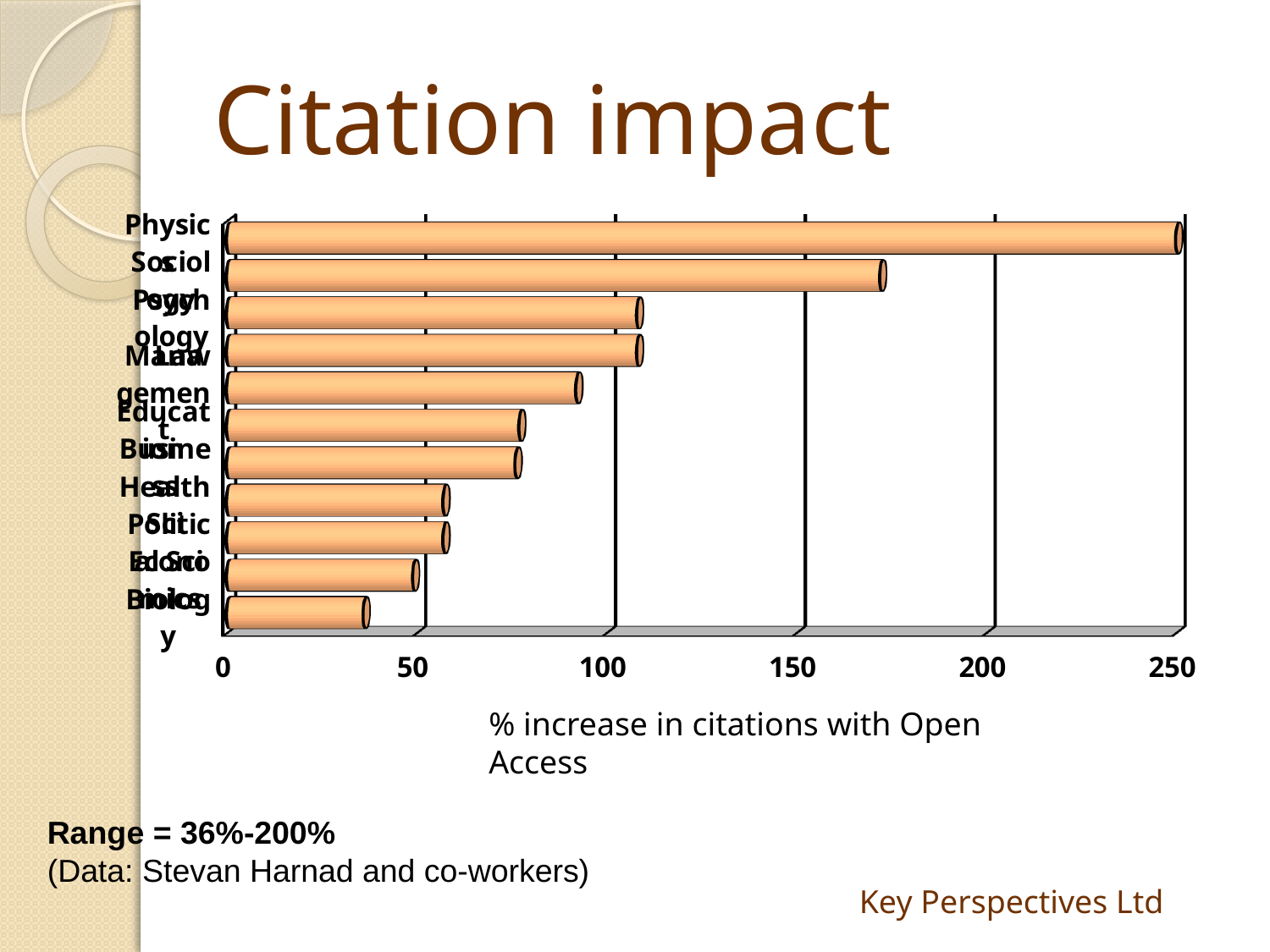
Which category has the longest bar in the chart? Physics Is the value of the fifth bar from the top greater or less than 100? less Is the value of the third bar from the top greater or less than 100? greater Is the value for Physics greater or less than 200? greater How many bars does the chart contain? 11 What kind of chart is shown on the slide? bar chart Which is larger, the value of the top bar or the value of the second bar from the top? the top bar What is the x-axis title of the chart? % increase in citations with Open Access What is the maximum value shown on the x axis? 250